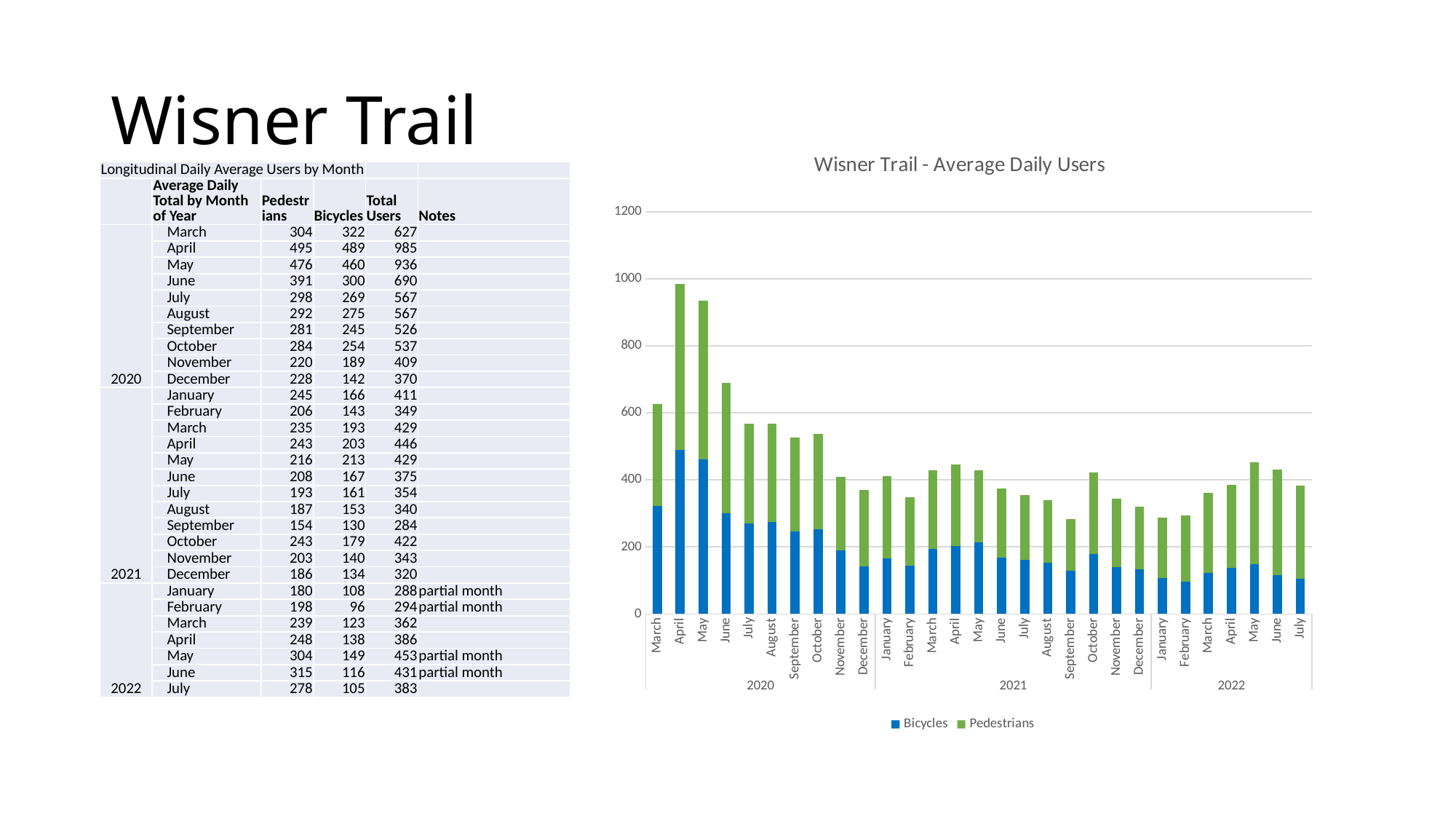
What is the Bicycles value for April 2020? 489 What are the two series named in the chart legend? Bicycles and Pedestrians Is the total bar for December 2021 greater or less than 400? less What is the total of the stacked bar for April 2020? 985 Is the total bar for April 2020 greater or less than 800? greater Which has the larger total bar, May 2020 or June 2020? May 2020 What is the title of the chart? Wisner Trail - Average Daily Users Which month has the tallest bar in the chart? April 2020 What kind of chart is shown on the slide? bar chart What is the difference between the total users for April 2020 and May 2020? 49 How many monthly bars are plotted in the chart? 29 How many series does the legend of the chart list? 2